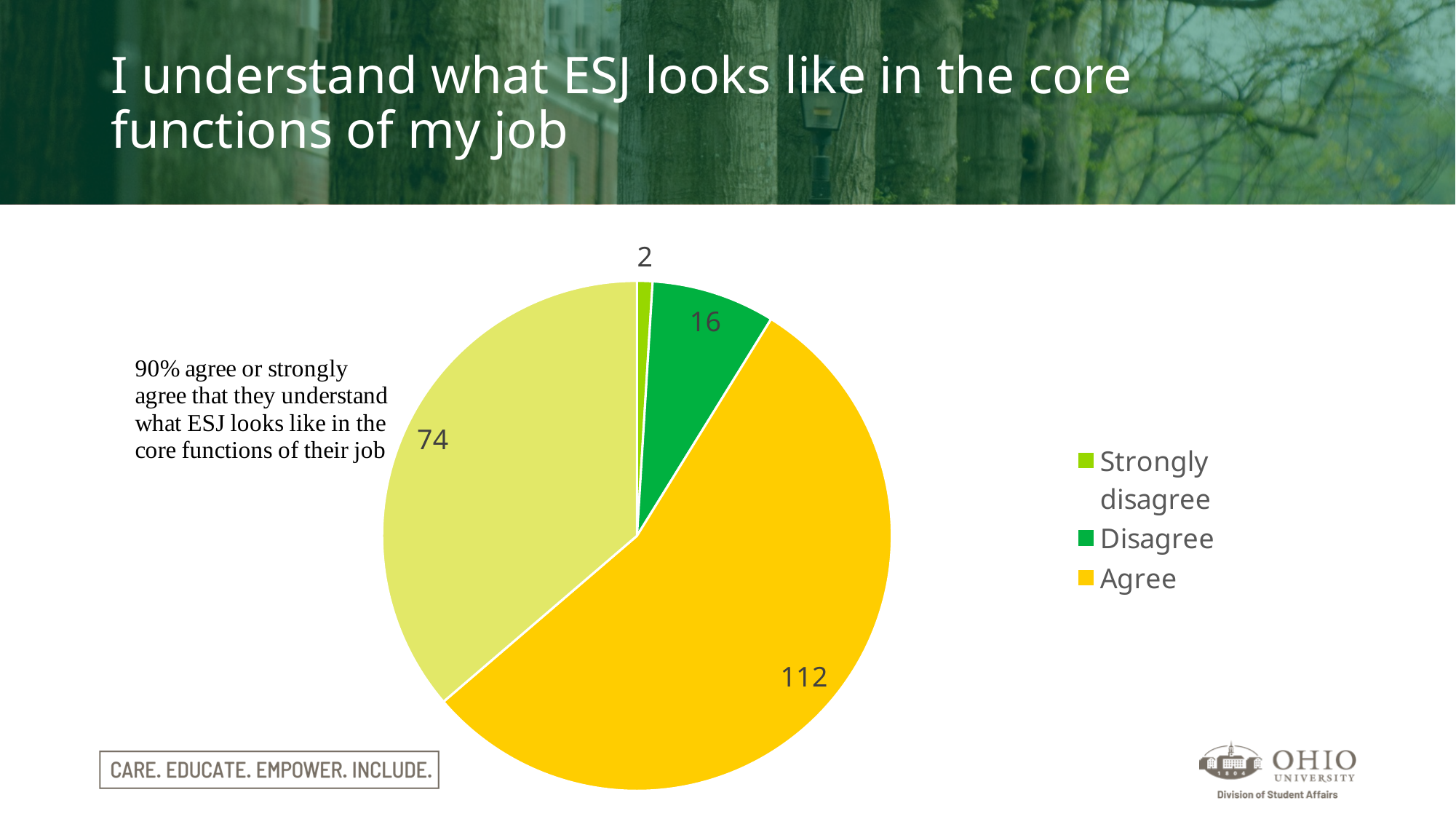
What is the difference between the Agree value and the Disagree value? 96 How many entries does the legend list? 3 What is the difference between the Disagree value and the Strongly disagree value? 14 What is the value of the Strongly disagree slice? 2 What is the value of the Agree slice? 112 What is the total of all the slice values shown on the pie chart? 204 What kind of chart is shown on the slide? pie chart What is the value of the Disagree slice? 16 Which category has the largest slice of the pie? Agree Which is larger, the Disagree slice or the Strongly disagree slice? Disagree Which category has the smallest slice of the pie? Strongly disagree How many slices does the pie chart have? 4